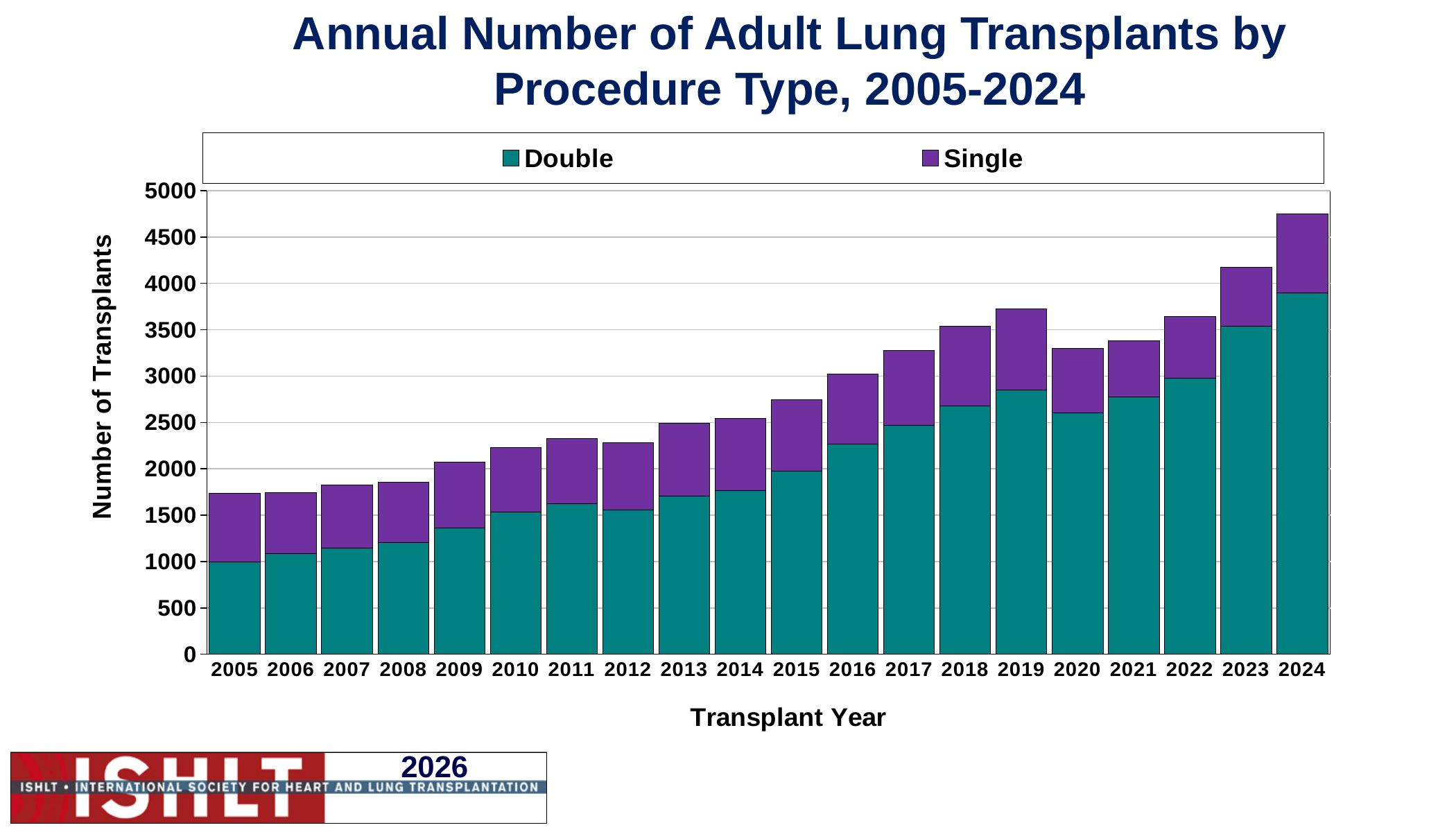
Is the total number of transplants in 2024 greater or less than 4500? greater Does the total number of adult lung transplants generally rise or fall from 2005 to 2024? rise How many series does the legend list? 2 Which year has the highest total number of adult lung transplants? 2024 Which year has the highest number of Double lung transplants? 2024 Is the total number of transplants in 2005 greater or less than 2000? less What is the label of the y axis? Number of Transplants Is the number of Double transplants in 2019 greater or less than 3000? less Which year has the larger total number of transplants, 2019 or 2020? 2019 How many transplant years are shown on the x axis? 20 What kind of chart is shown on the slide? Stacked bar chart